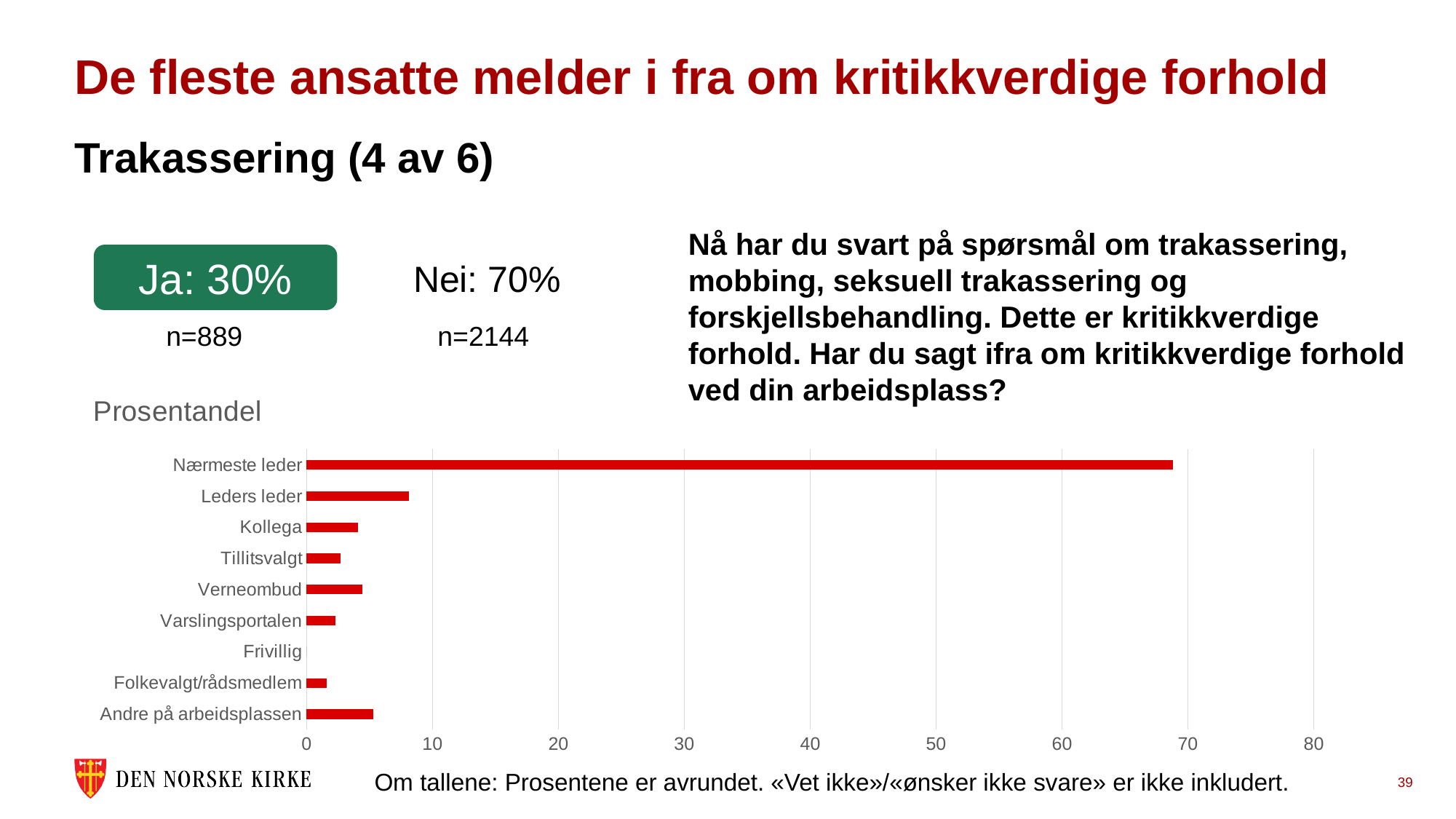
What is the title shown above the chart? Prosentandel Which category has the lowest value in the chart? Frivillig Is the value for Nærmeste leder greater or less than 70? less Is the value for Nærmeste leder greater or less than 60? greater What kind of chart is shown on the slide? bar chart Is the value for Andre på arbeidsplassen greater or less than 10? less How many categories are shown in the chart? 9 Which is larger, the value for Leders leder or the value for Kollega? Leders leder Which category has the highest value in the chart? Nærmeste leder Which is larger, the value for Andre på arbeidsplassen or the value for Folkevalgt/rådsmedlem? Andre på arbeidsplassen What colour are the bars in the chart? red